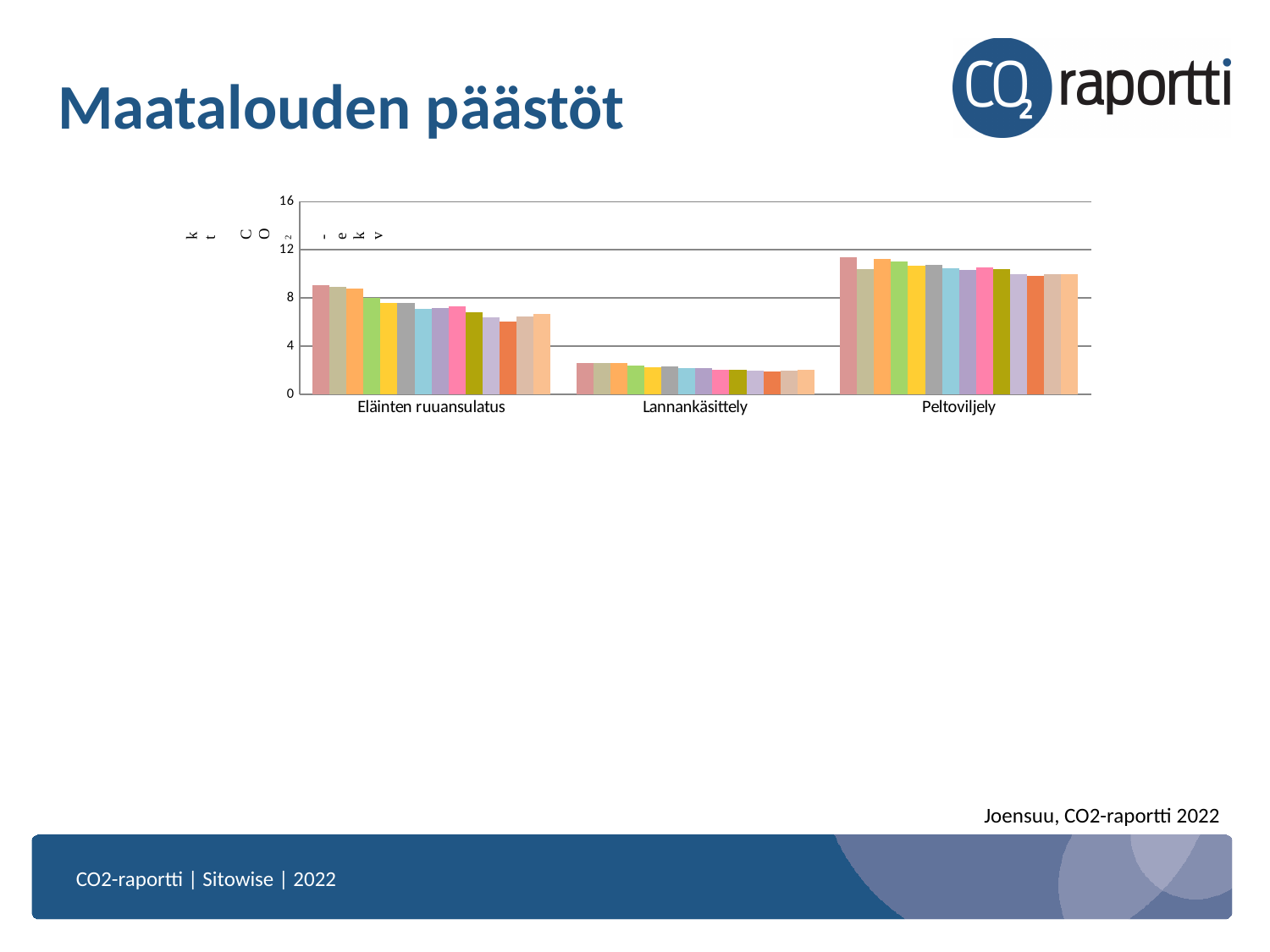
Do the bars within the Eläinten ruuansulatus category generally rise or fall from left to right? fall What kind of chart is shown on the slide? bar chart What is the highest value shown on the chart's y axis? 16 Are the bars for Peltoviljely greater or less than 8? greater How many categories are shown on the x axis of the chart? 3 What is the title of the slide containing the chart? Maatalouden päästöt Which category has the lowest bars in the chart? Lannankäsittely Are the bars for Peltoviljely greater or less than 12? less Which category has larger values, Eläinten ruuansulatus or Lannankäsittely? Eläinten ruuansulatus Which category has larger values, Peltoviljely or Eläinten ruuansulatus? Peltoviljely Are the bars for Lannankäsittely greater or less than 4? less Which category has the highest bars in the chart? Peltoviljely